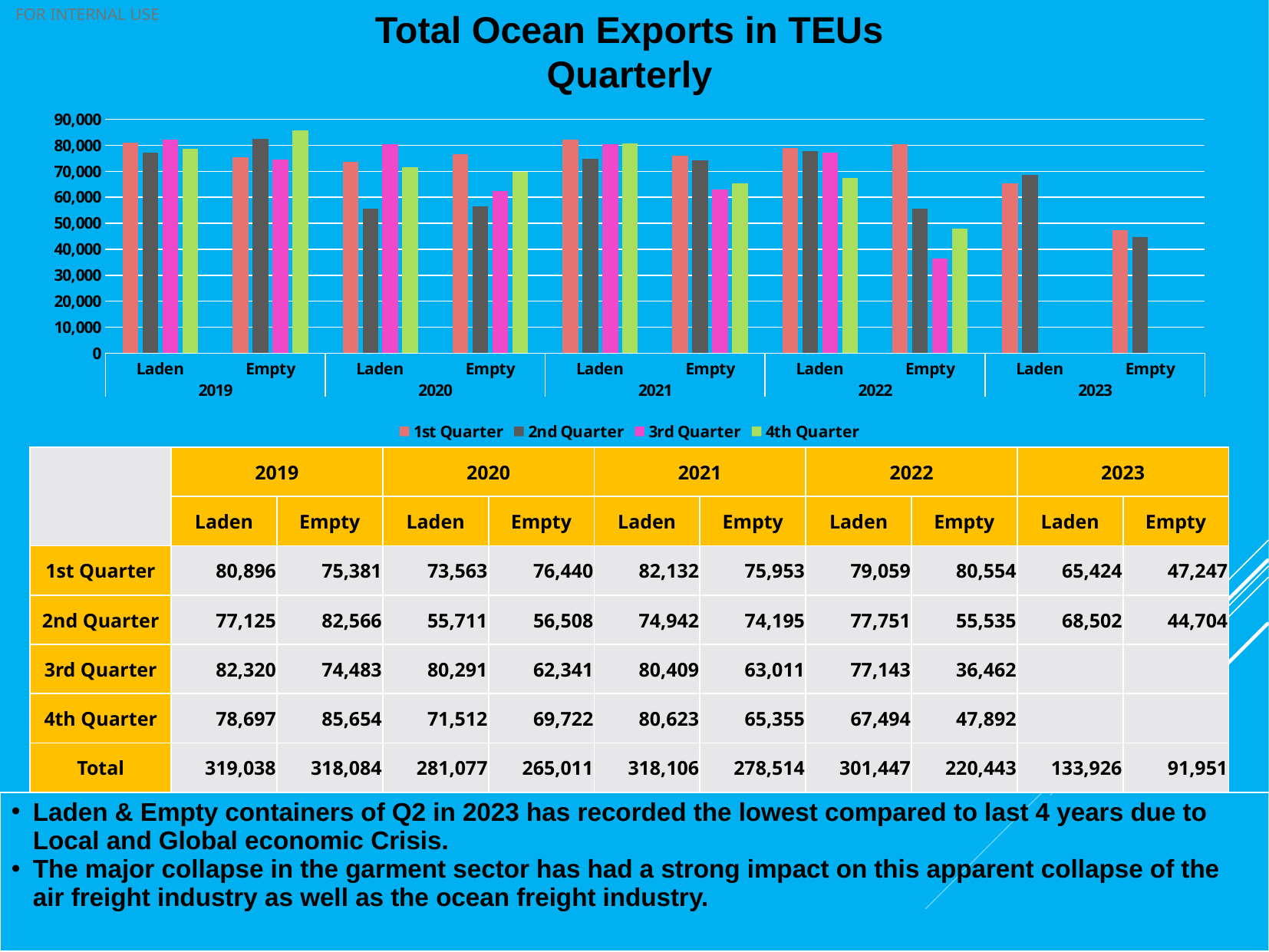
What is the total Laden value for 2021? 318,106 Which quarter has the lowest Empty value in 2022? 3rd Quarter What kind of chart is shown on the slide? bar chart What is the 3rd Quarter value for Empty in 2022? 36,462 What is the 1st Quarter value for Laden in 2019? 80,896 How many series does the chart legend list? 4 What is the difference between the 2nd Quarter and 1st Quarter Laden values in 2023? 3,078 How many years are shown along the x axis of the chart? 5 Which is larger for Laden in 2020: the 1st Quarter or the 3rd Quarter value? 3rd Quarter Which quarter has the highest Empty value in 2019? 4th Quarter Is the 3rd Quarter Empty value for 2022 greater or less than 40,000? less Do the Empty values for 2023 rise or fall from the 1st Quarter to the 2nd Quarter? fall